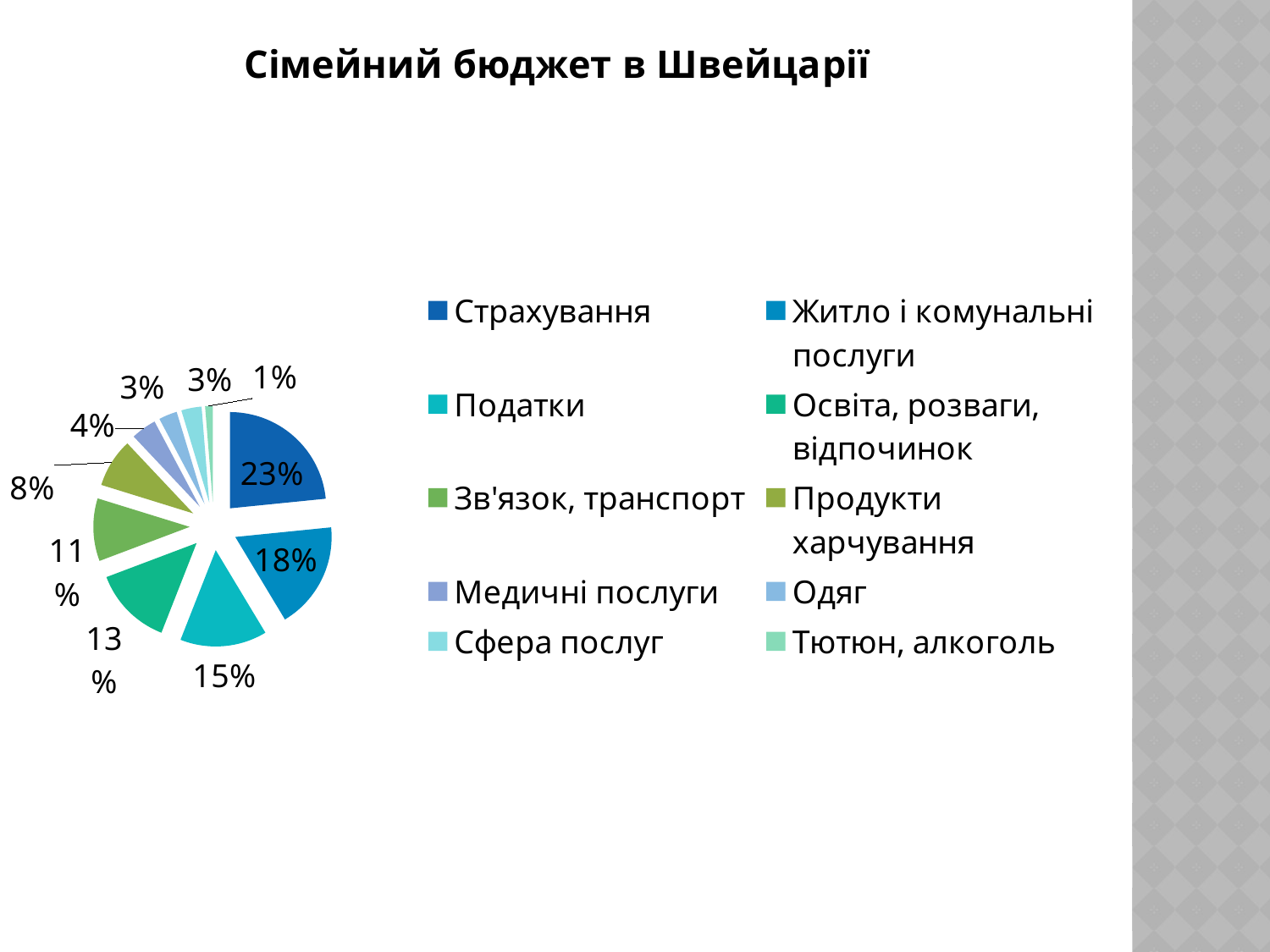
What share of the family budget goes to Тютюн, алкоголь? 1% What share of the family budget goes to Страхування? 23% What kind of chart is shown on the slide? pie chart What share of the family budget goes to Продукти харчування? 8% How many categories does the legend list? 10 Which category has the smallest share of the family budget? Тютюн, алкоголь What is the title of the chart? Сімейний бюджет в Швейцарії Which category has the largest share of the family budget? Страхування What share of the family budget goes to Податки? 15% Which is larger, the share for Освіта, розваги, відпочинок or the share for Зв'язок, транспорт? Освіта, розваги, відпочинок What share of the family budget goes to Житло і комунальні послуги? 18% How many percentage points larger is the share for Страхування than for Житло і комунальні послуги? 5